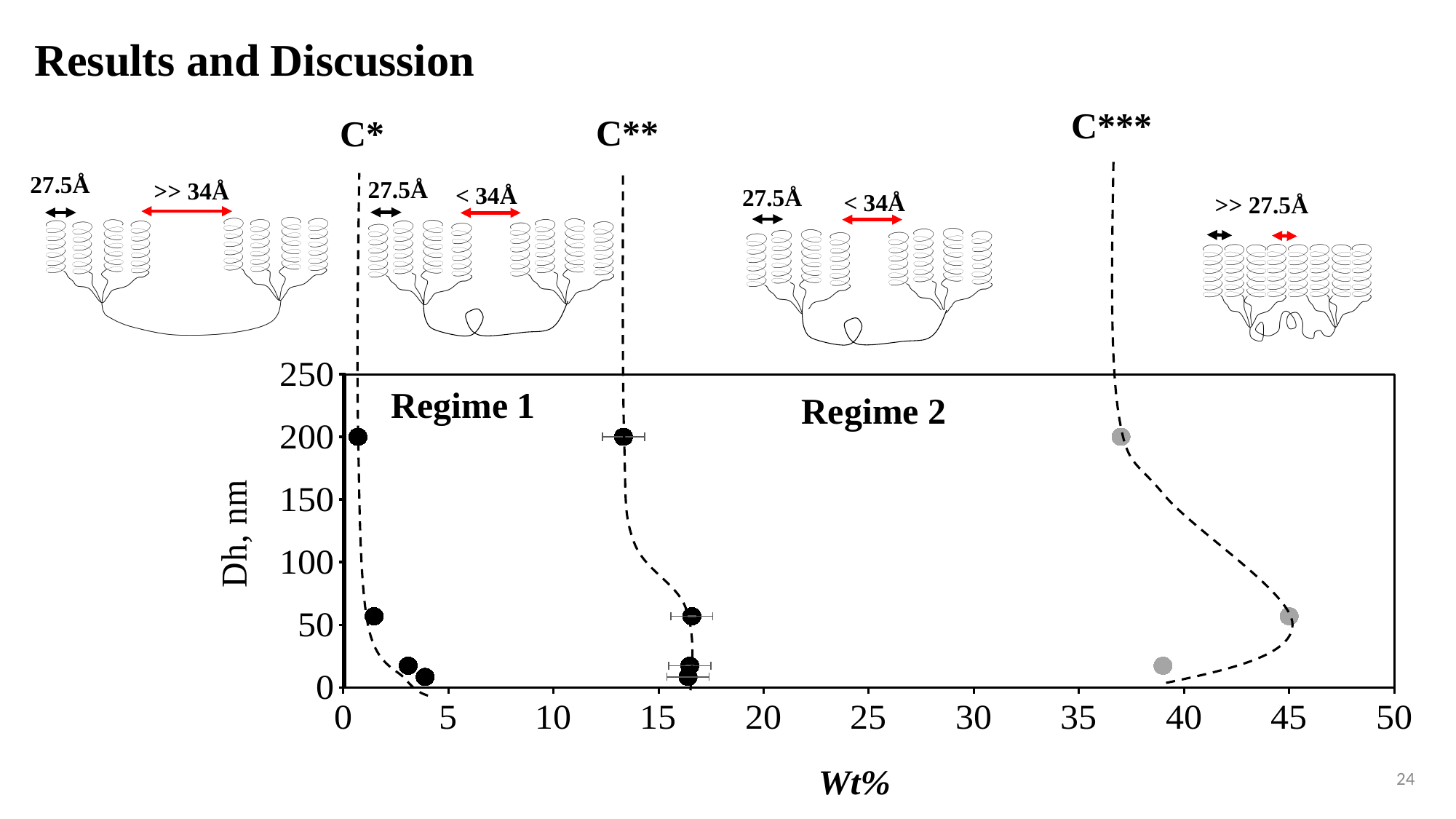
Is the Dh value of the gray point near 37 Wt% greater or less than 150 nm? greater What is the label of the y axis of the chart? Dh, nm Which regime label appears on the left side of the chart, Regime 1 or Regime 2? Regime 1 What is the label of the x axis of the chart? Wt% Is the Dh value of the gray point near 45 Wt% greater or less than 100 nm? less How many gray data points are plotted on the chart? 3 Is the Dh value of the black point near 13 Wt% greater or less than 150 nm? greater What kind of chart is shown on the slide? scatter plot